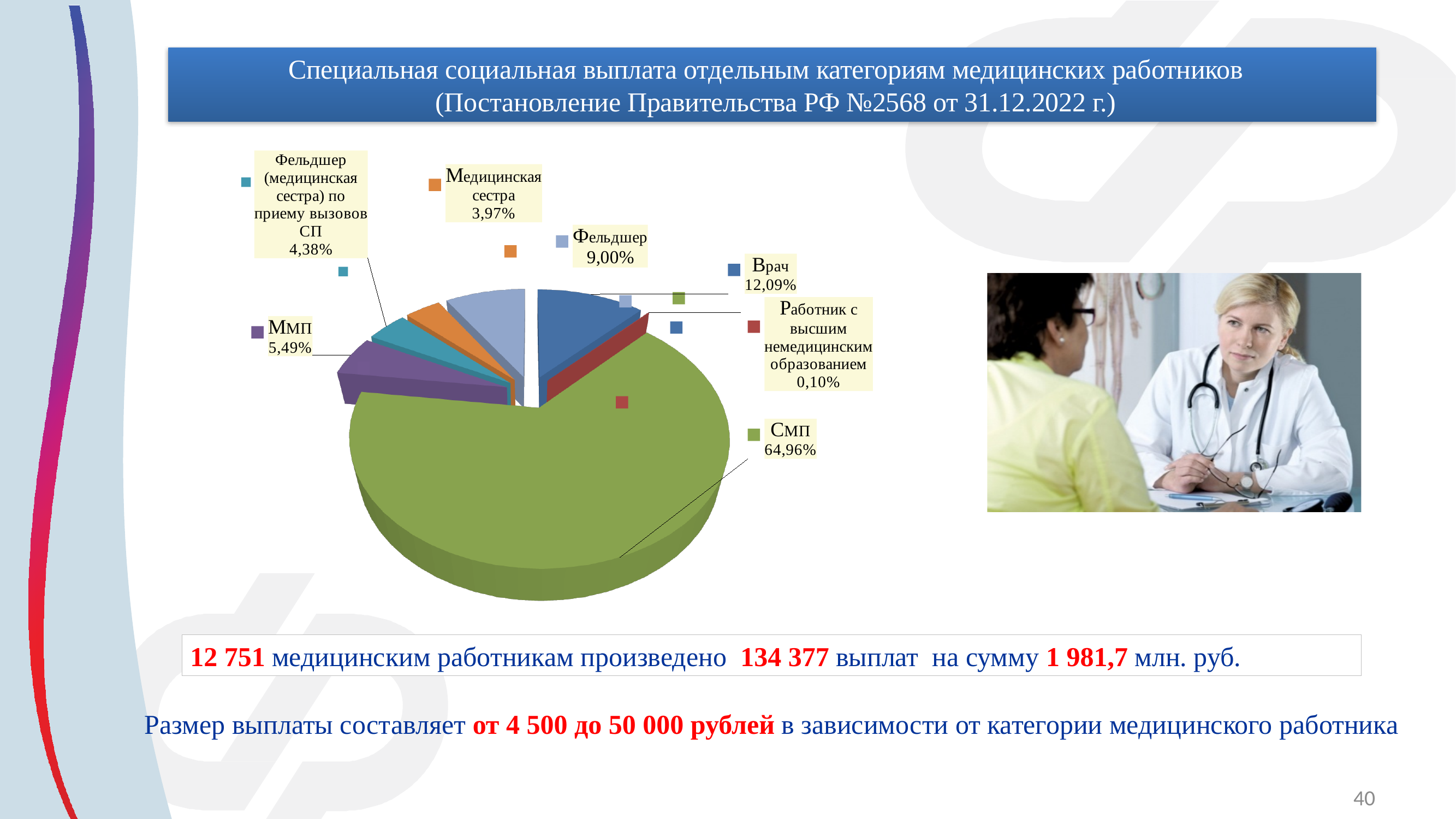
What share of the pie does the Смп slice have? 64,96% What share of the pie does the Работник с высшим немедицинским образованием slice have? 0,10% What share of the pie does the Ммп slice have? 5,49% Which category has the smallest slice of the pie? Работник с высшим немедицинским образованием Which category has the largest slice of the pie? Смп What kind of chart is shown on the slide? pie chart How many slices does the pie chart have? 7 Which slice is larger, Ммп or Медицинская сестра? Ммп What is the difference between the Врач share and the Фельдшер share? 3,09%